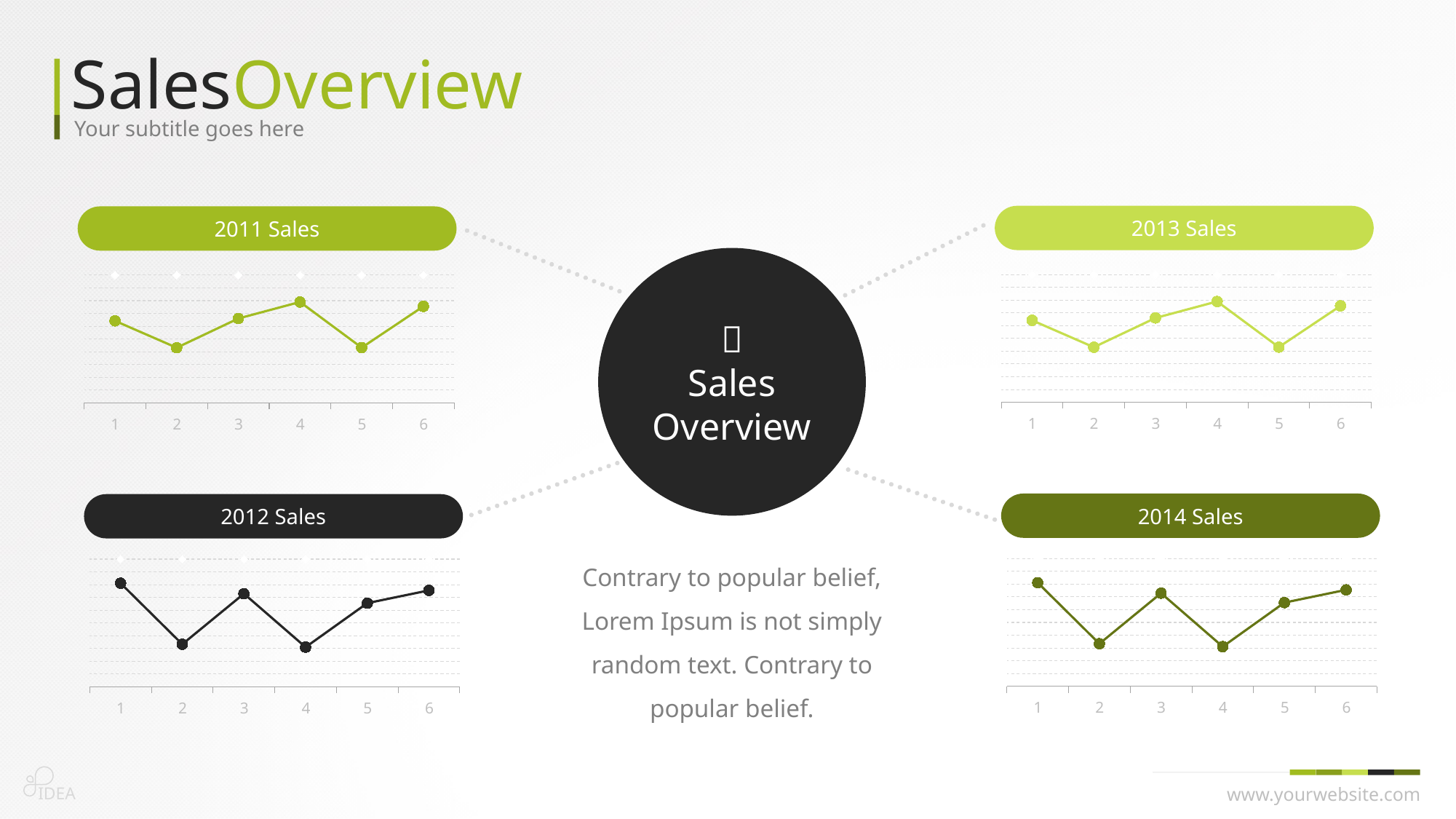
How many line charts are shown on the slide? 4 How many data points are plotted on the 2011 Sales chart? 6 On the 2011 Sales chart, is the value at category 4 larger or smaller than the value at category 2? larger On the 2012 Sales chart, is the value at category 3 larger or smaller than the value at category 4? larger What kind of chart is the 2011 Sales chart? line chart On the 2014 Sales chart, does the line rise or fall from category 4 to category 6? rise On the 2013 Sales chart, which x-axis category has the highest value? 4 What is the title of the chart in the bottom-right of the slide? 2014 Sales On the 2012 Sales chart, is the value at category 1 larger or smaller than the value at category 2? larger On the 2013 Sales chart, does the line rise or fall from category 1 to category 2? fall On the 2011 Sales chart, which x-axis category has the highest value? 4 How many data points are plotted on the 2012 Sales chart? 6